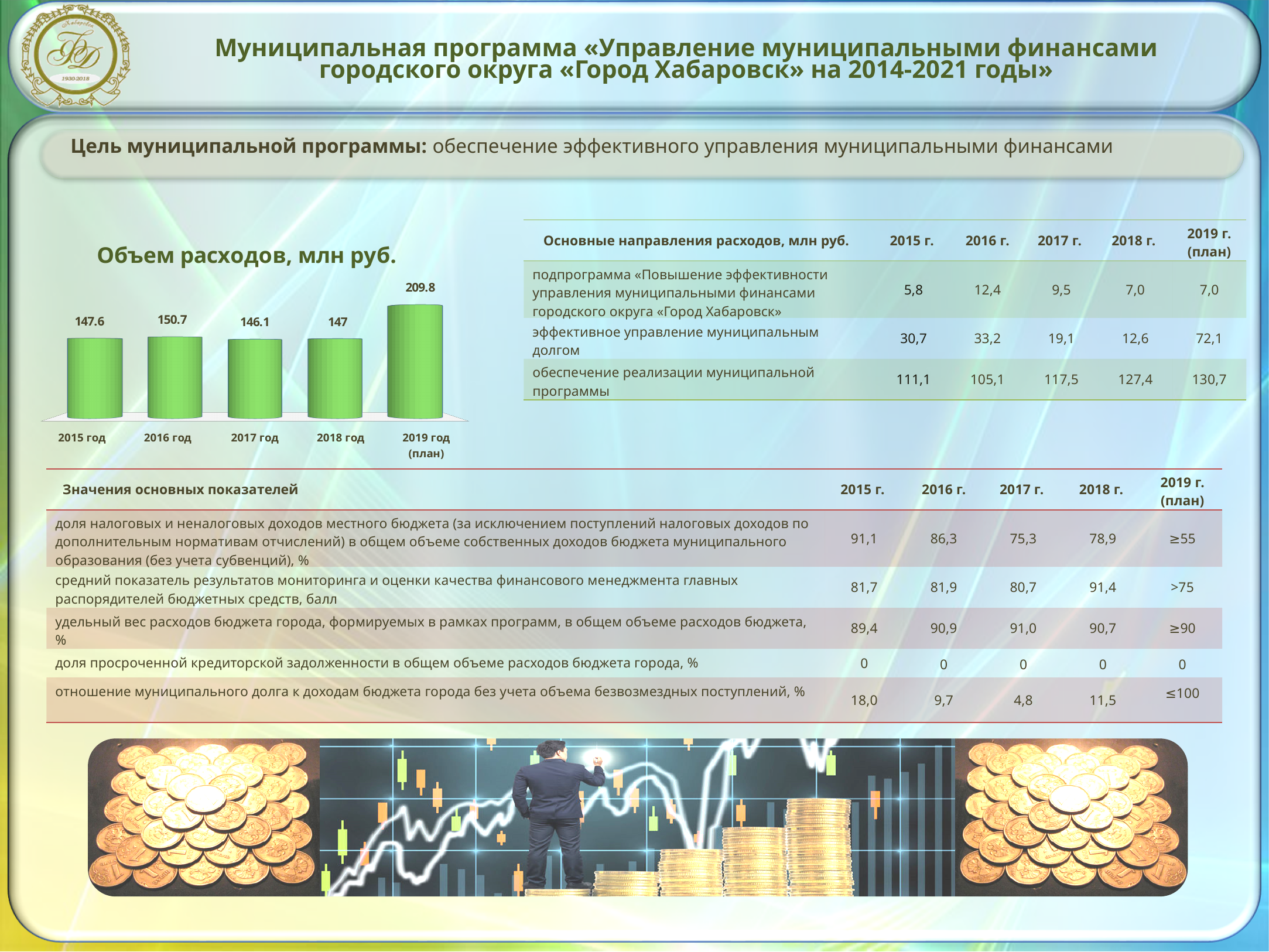
Which year has the highest value in the chart «Объем расходов, млн руб.»? 2019 год (план) How many bars are shown in the chart «Объем расходов, млн руб.»? 5 In the chart «Объем расходов, млн руб.», which is larger: the value for 2016 год or the value for 2017 год? 2016 год What is the planned value for 2019 год (план) in the chart «Объем расходов, млн руб.»? 209.8 In the chart «Объем расходов, млн руб.», what is the difference between the 2016 год value and the 2015 год value? 3.1 What is the value for 2015 год in the chart «Объем расходов, млн руб.»? 147.6 In the chart «Объем расходов, млн руб.», what is the difference between the 2019 год (план) value and the 2018 год value? 62.8 In the chart «Объем расходов, млн руб.», does the value rise or fall from 2018 год to 2019 год (план)? rise What colour are the bars in the chart «Объем расходов, млн руб.»? green Which year has the lowest value in the chart «Объем расходов, млн руб.»? 2017 год What type of chart is shown under the title «Объем расходов, млн руб.»? bar chart What is the value for 2017 год in the chart «Объем расходов, млн руб.»? 146.1